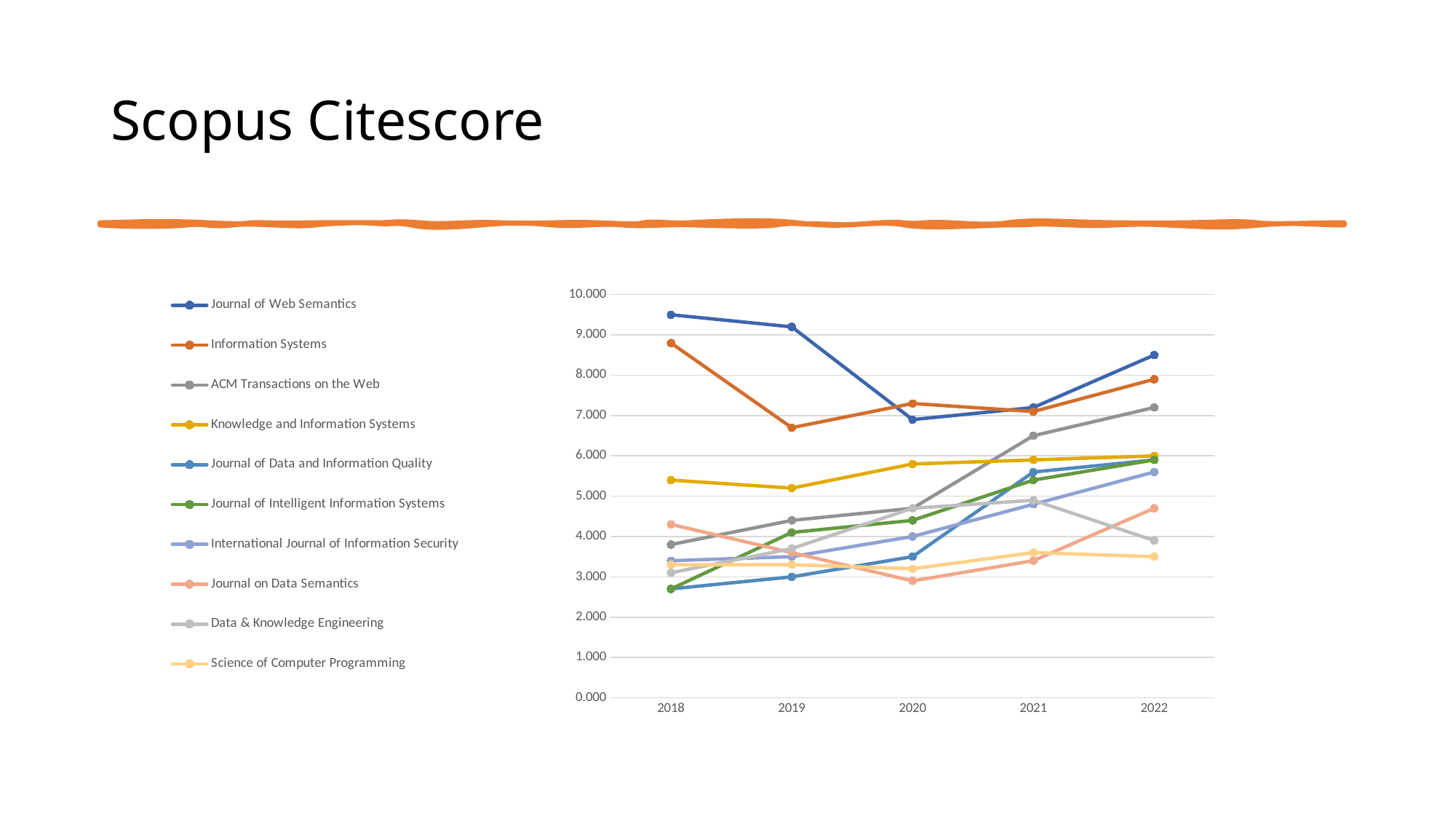
Is the value for Journal of Web Semantics in 2018 greater or less than 9.000? greater Which journal has the lowest Citescore in 2022? Science of Computer Programming Which journal has the highest Citescore in 2022? Journal of Web Semantics In 2022, which is larger: Information Systems or ACM Transactions on the Web? Information Systems Does the line for ACM Transactions on the Web rise or fall from 2018 to 2022? rise Which journal has the highest Citescore in 2018? Journal of Web Semantics What kind of chart is shown on the slide? line chart Is the value for Information Systems in 2019 greater or less than 7.000? less Is the value for Knowledge and Information Systems in 2022 greater or less than 5.000? greater What is the title of the slide? Scopus Citescore How many years are shown along the x axis? 5 How many series does the legend list? 10